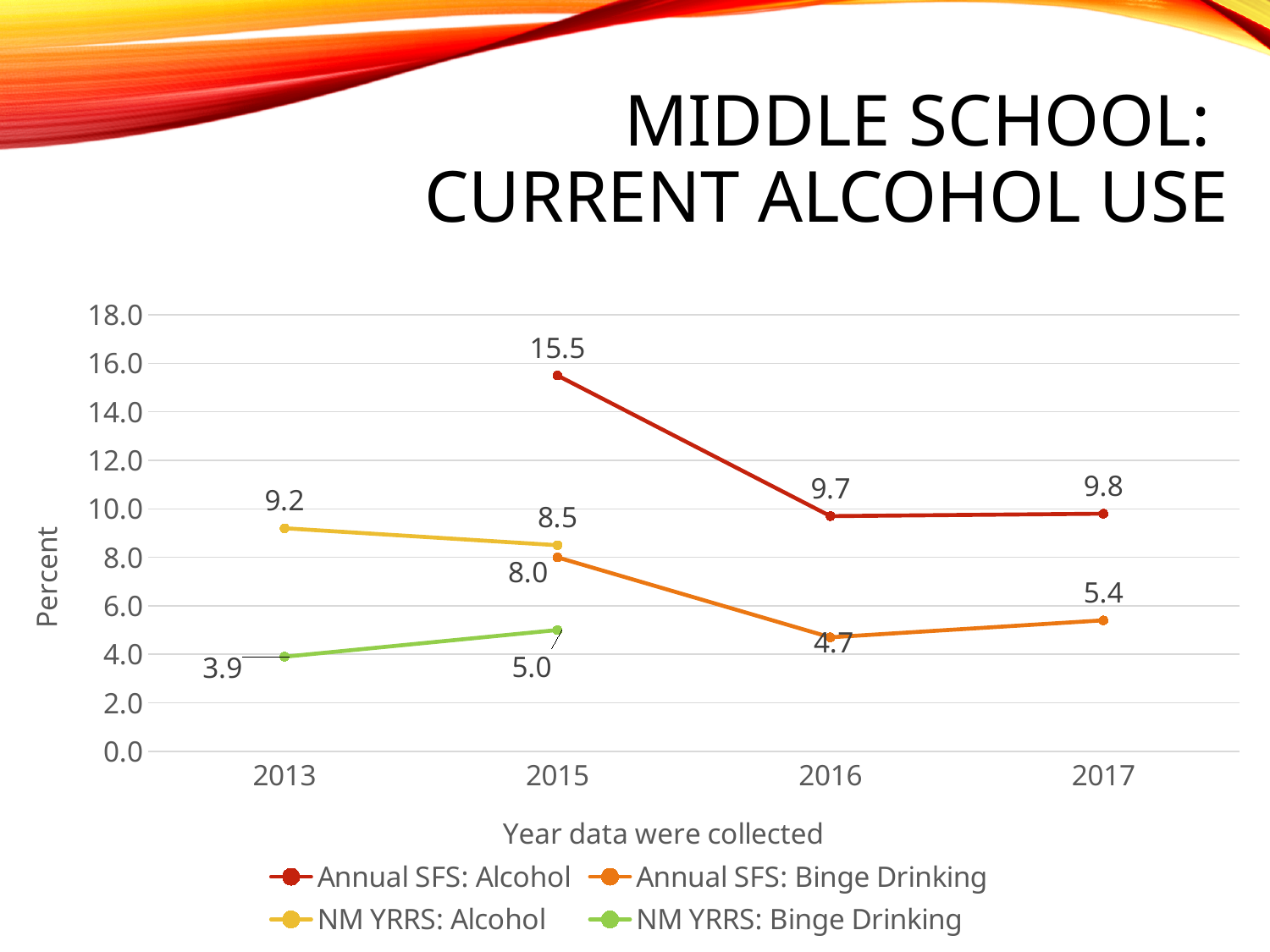
How many series does the legend list? 4 Does NM YRRS: Binge Drinking rise or fall from 2013 to 2015? Rise What type of chart is shown on the slide? Line chart What is the value for Annual SFS: Binge Drinking in 2016? 4.7 What is the value for Annual SFS: Alcohol in 2015? 15.5 What is the value for NM YRRS: Alcohol in 2013? 9.2 What is the difference between Annual SFS: Alcohol in 2015 and in 2016? 5.8 Which is larger: NM YRRS: Alcohol in 2013 or NM YRRS: Alcohol in 2015? 2013 What is the value for NM YRRS: Binge Drinking in 2015? 5.0 In which year is Annual SFS: Binge Drinking lowest? 2016 How many years are shown on the x axis? 4 In which year is Annual SFS: Alcohol highest? 2015